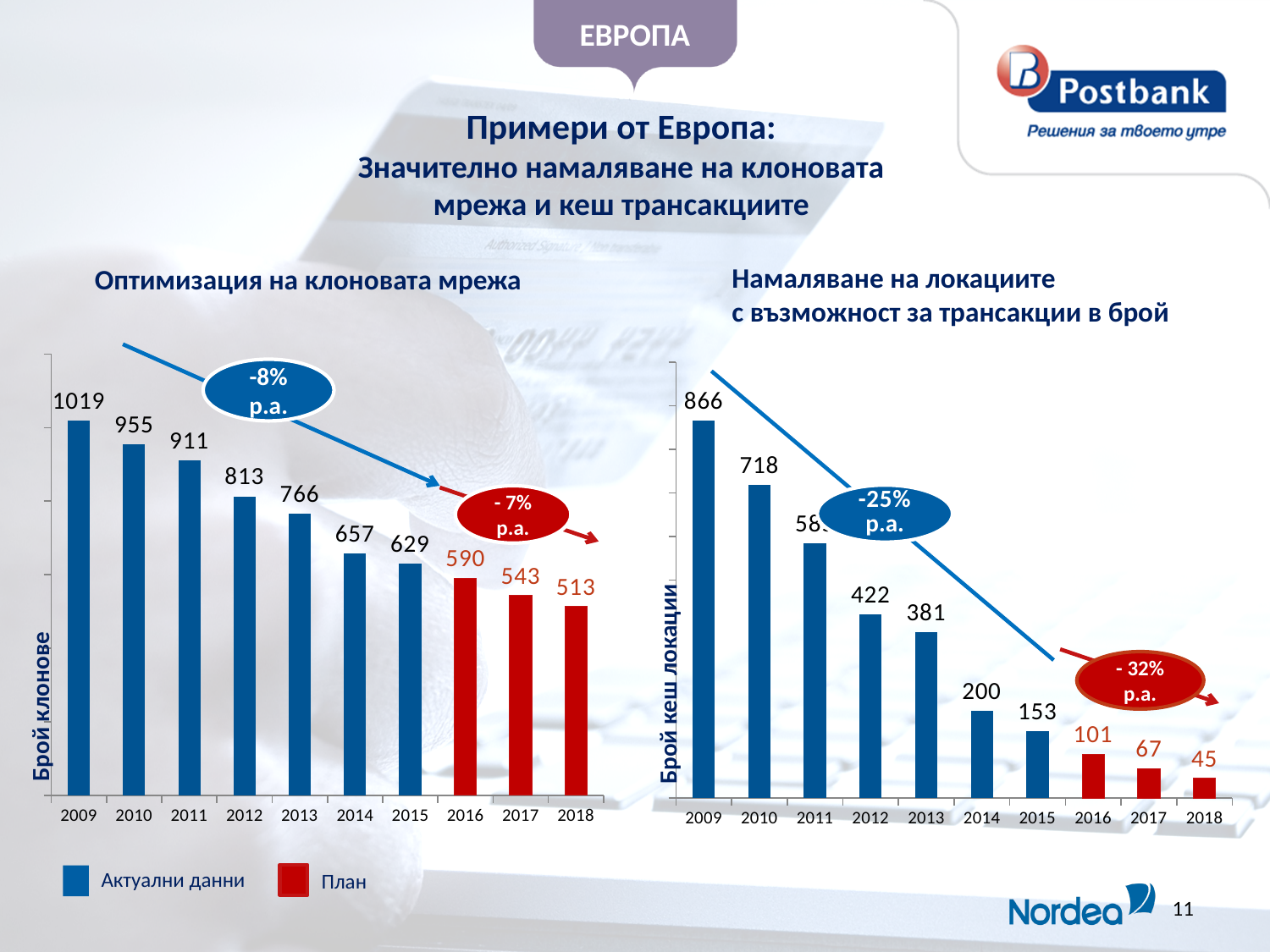
In the right chart (Намаляване на локациите с възможност за трансакции в брой), what is the value for 2014? 200 In the right chart (Намаляване на локациите с възможност за трансакции в брой), do the values rise or fall from 2009 to 2018? Fall In the left chart (Оптимизация на клоновата мрежа), which is larger, the value for 2013 or the value for 2014? 2013 In the left chart (Оптимизация на клоновата мрежа), what is the difference between the values for 2009 and 2018? 506 In the left chart (Оптимизация на клоновата мрежа), which year has the highest value? 2009 In the right chart (Намаляване на локациите с възможност за трансакции в брой), what is the value for 2018? 45 In the left chart (Оптимизация на клоновата мрежа), what is the value for 2009? 1019 How many years are shown on the x axis of the left chart (Оптимизация на клоновата мрежа)? 10 In the right chart (Намаляване на локациите с възможност за трансакции в брой), which year has the lowest value? 2018 What kind of chart is the right chart (Намаляване на локациите с възможност за трансакции в брой)? Bar chart In the left chart (Оптимизация на клоновата мрежа), what is the value for 2018? 513 In the right chart (Намаляване на локациите с възможност за трансакции в брой), what is the difference between the values for 2009 and 2010? 148